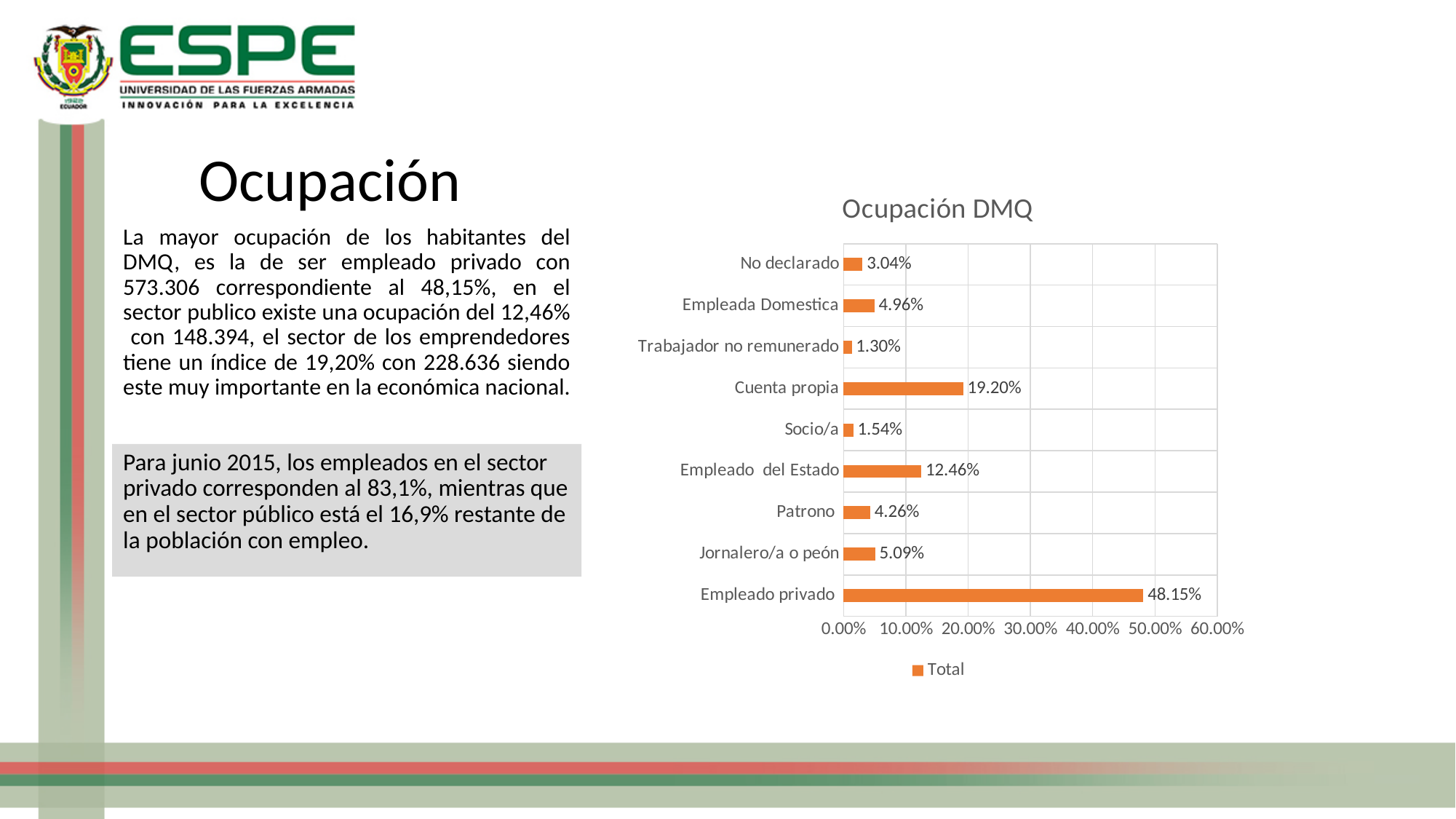
What kind of chart is shown? bar chart Which category has the highest value? Empleado privado Is the value for Empleado del Estado greater or less than 10.00%? greater What is the value for Empleado privado? 48.15% Which category has the lowest value? Trabajador no remunerado What is the value for Trabajador no remunerado? 1.30% Which is larger, the value for Jornalero/a o peón or the value for Patrono? Jornalero/a o peón How many categories are shown in the chart? 9 What is the value for Empleado del Estado? 12.46% What is the difference between the values for Empleado privado and Cuenta propia? 28.95% What is the title of the chart? Ocupación DMQ What is the value for Cuenta propia? 19.20%